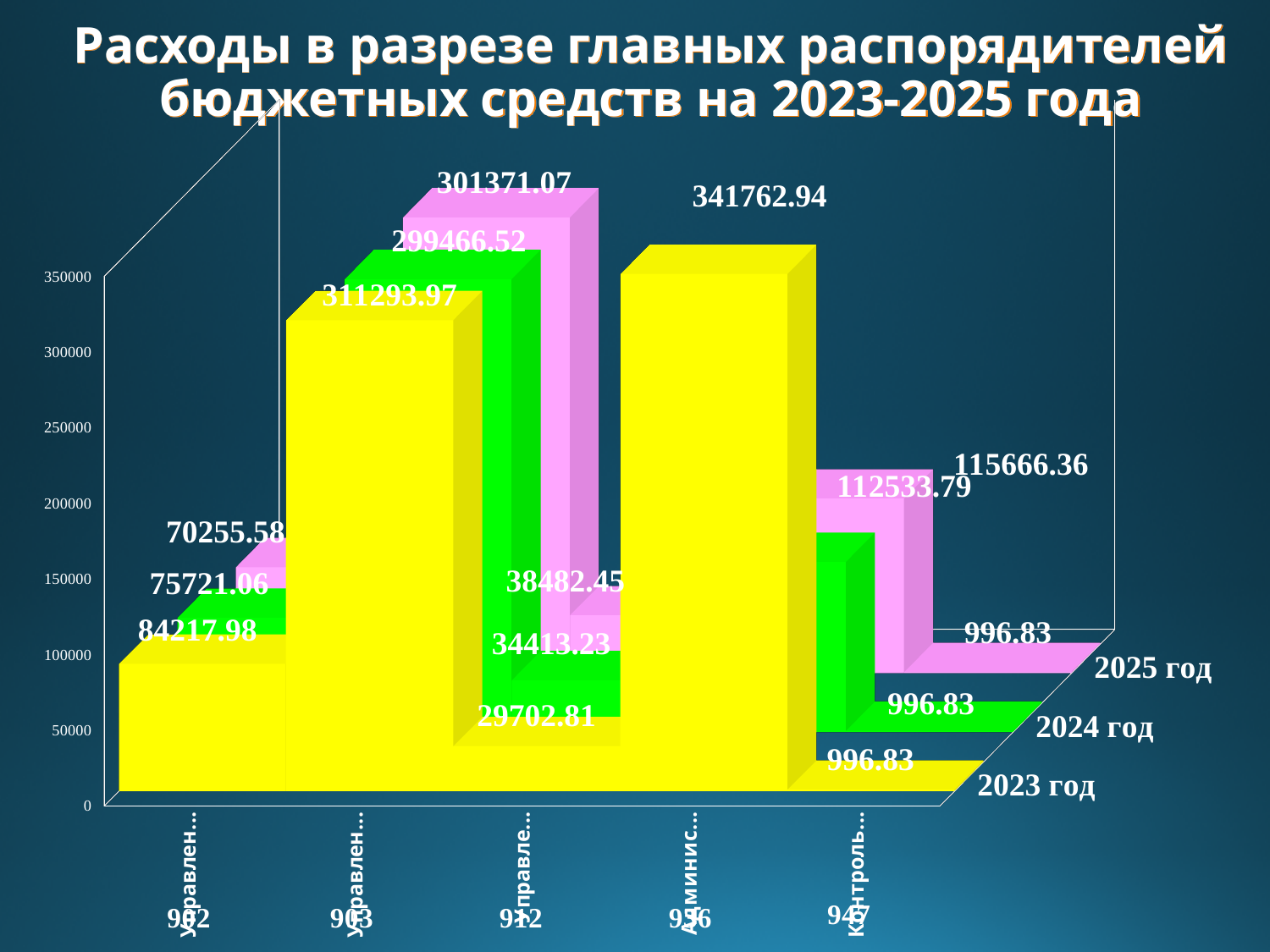
What is the 2023 год value for category 947? 996.83 How many categories (main budget administrators) are plotted along the x axis? 5 How many series (years) does the chart show? 3 Which category has the lowest 2023 год value? 947 What kind of chart is shown on the slide? bar chart What is the 2023 год value for category 903? 311293.97 Which category has the highest 2023 год value? 956 What is the 2025 год value for category 912? 38482.45 What is the 2024 год value for category 902? 75721.06 For category 912, do the values rise or fall from 2023 год to 2025 год? rise For category 902, how much larger is the 2023 год value than the 2024 год value? 8496.92 For category 903, which is larger: the 2024 год value or the 2025 год value? 2025 год